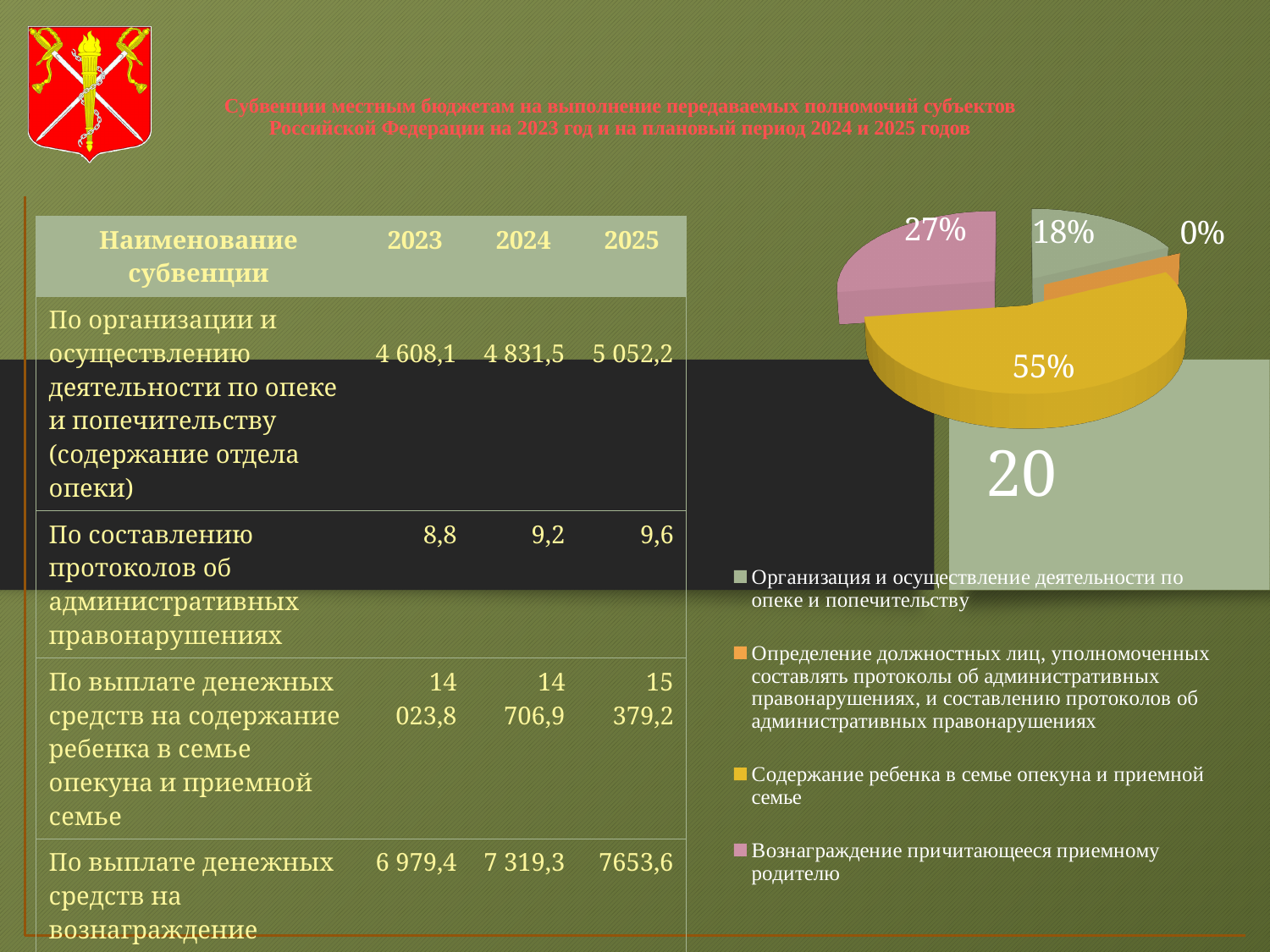
Which category has the largest slice in the pie chart? Содержание ребенка в семье опекуна и приемной семье What colour is the largest slice of the pie chart? Yellow What share of the pie chart is labelled for 'Организация и осуществление деятельности по опеке и попечительству'? 18% What share of the pie chart is labelled for 'Определение должностных лиц, уполномоченных составлять протоколы об административных правонарушениях, и составлению протоколов об административных правонарушениях'? 0% What kind of chart is shown on the right side of the slide? Pie chart In the pie chart, which is larger: the slice for 'Вознаграждение причитающееся приемному родителю' or the slice for 'Организация и осуществление деятельности по опеке и попечительству'? Вознаграждение причитающееся приемному родителю How many slices are labelled on the pie chart? 4 What share of the pie chart is labelled for 'Содержание ребенка в семье опекуна и приемной семье'? 55% What is the difference in percentage points between the 55% slice and the 27% slice in the pie chart? 28 Which category has the smallest slice in the pie chart? Определение должностных лиц, уполномоченных составлять протоколы об административных правонарушениях, и составлению протоколов об административных правонарушениях How many entries does the legend of the pie chart list? 4